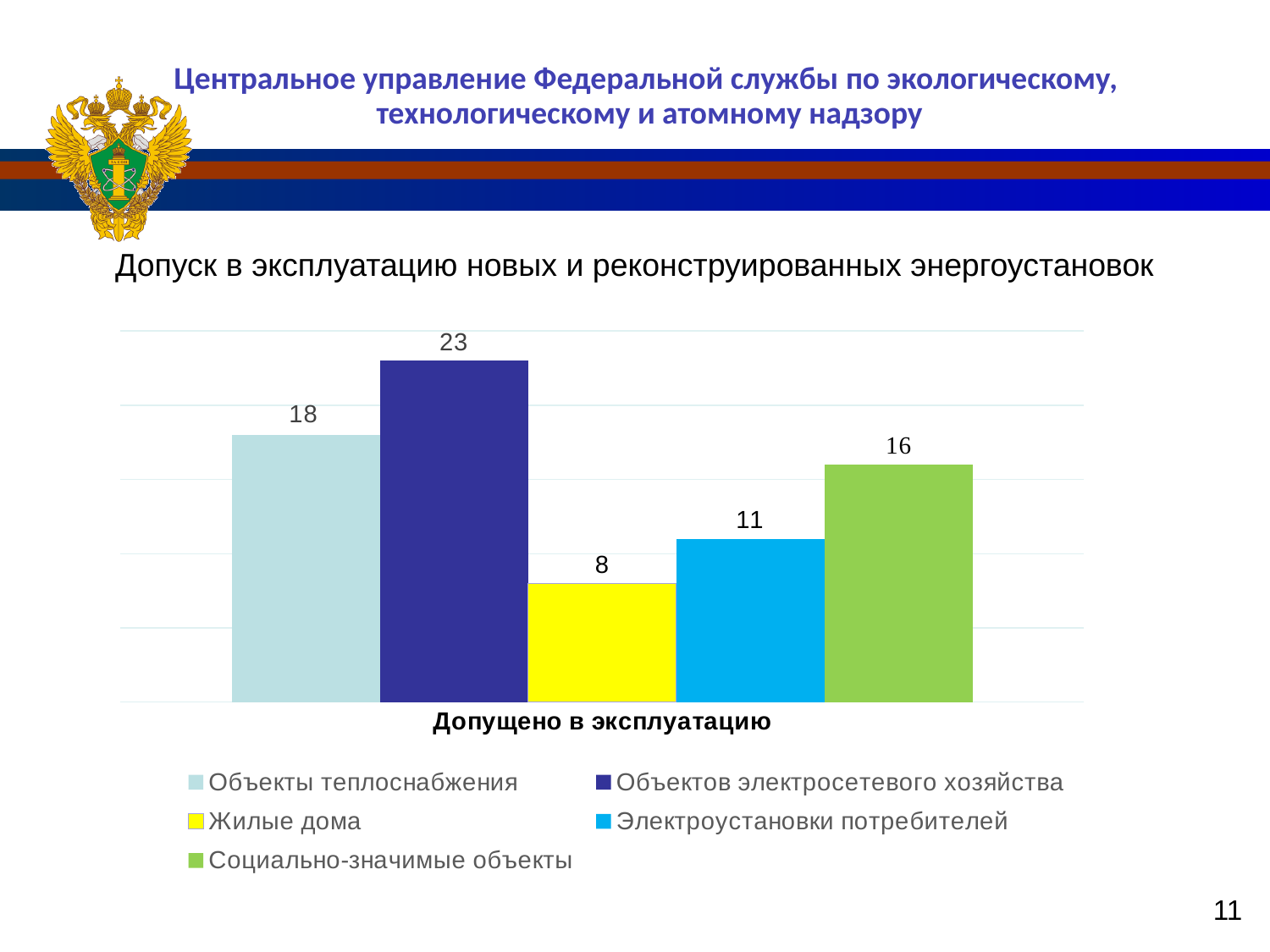
What is the difference between the values for Объектов электросетевого хозяйства and Объекты теплоснабжения? 5 Which series has the highest value? Объектов электросетевого хозяйства What is the value for Социально-значимые объекты? 16 What is the value for Электроустановки потребителей? 11 What is the value for Объектов электросетевого хозяйства? 23 What kind of chart is shown on the slide? Bar chart How many series does the legend list? 5 What is the value for Жилые дома? 8 Which is larger, the value for Социально-значимые объекты or the value for Электроустановки потребителей? Социально-значимые объекты What is the title of the chart? Допуск в эксплуатацию новых и реконструированных энергоустановок Which series has the lowest value? Жилые дома What is the value for Объекты теплоснабжения? 18